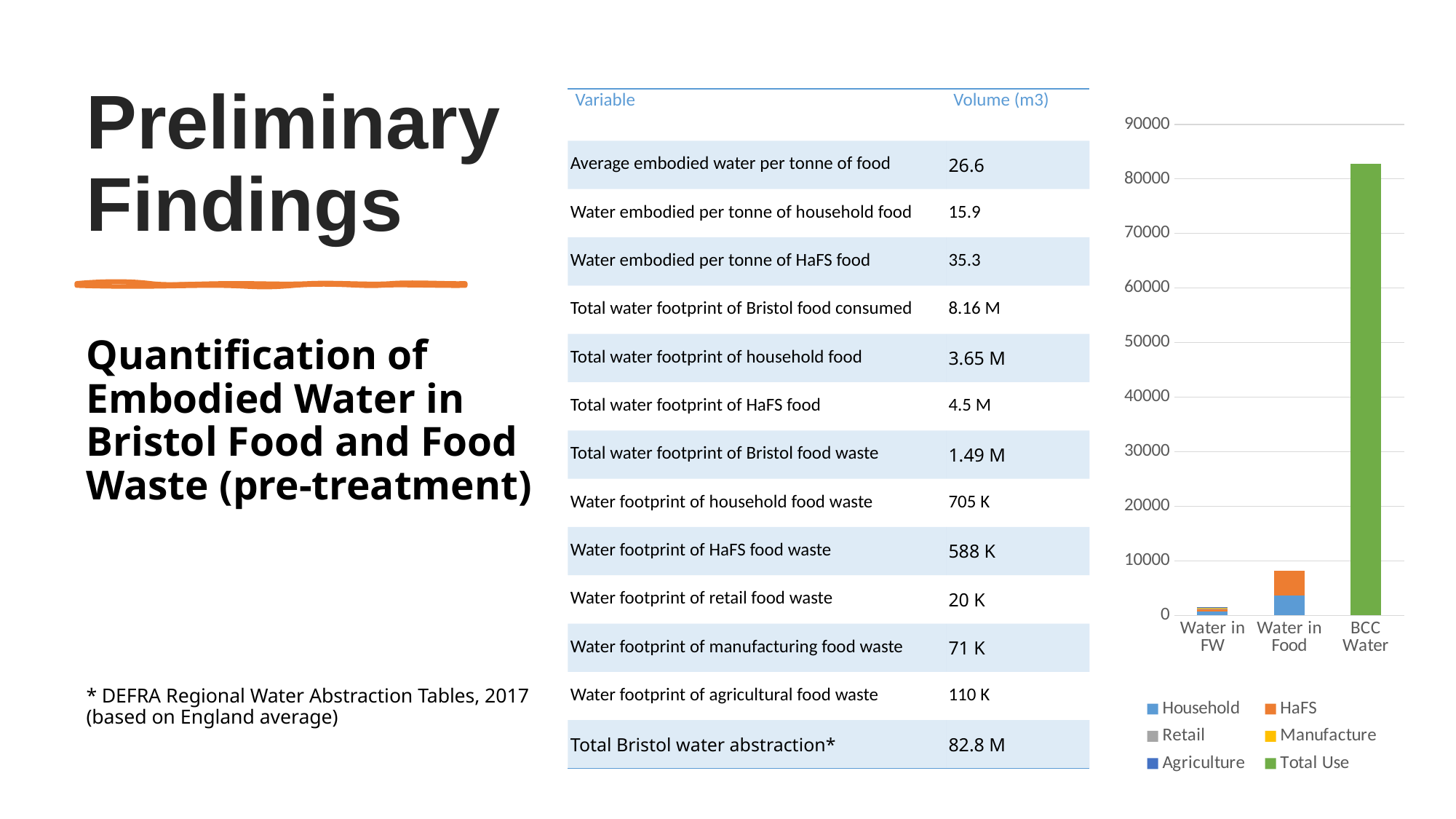
Which bar is taller, Water in Food or Water in FW? Water in Food Which legend series is shown in green in the chart? Total Use Is the value for BCC Water greater or less than 80000? greater How many categories are shown on the x axis of the bar chart? 3 Which legend series is shown in orange in the chart? HaFS Is the total value for Water in FW greater or less than 10000? less Which category has the shortest bar in the chart? Water in FW Which category has the tallest bar in the chart? BCC Water Is the value for BCC Water greater or less than 70000? greater How many series does the legend of the bar chart list? 6 What kind of chart is shown on the right of the slide? bar chart